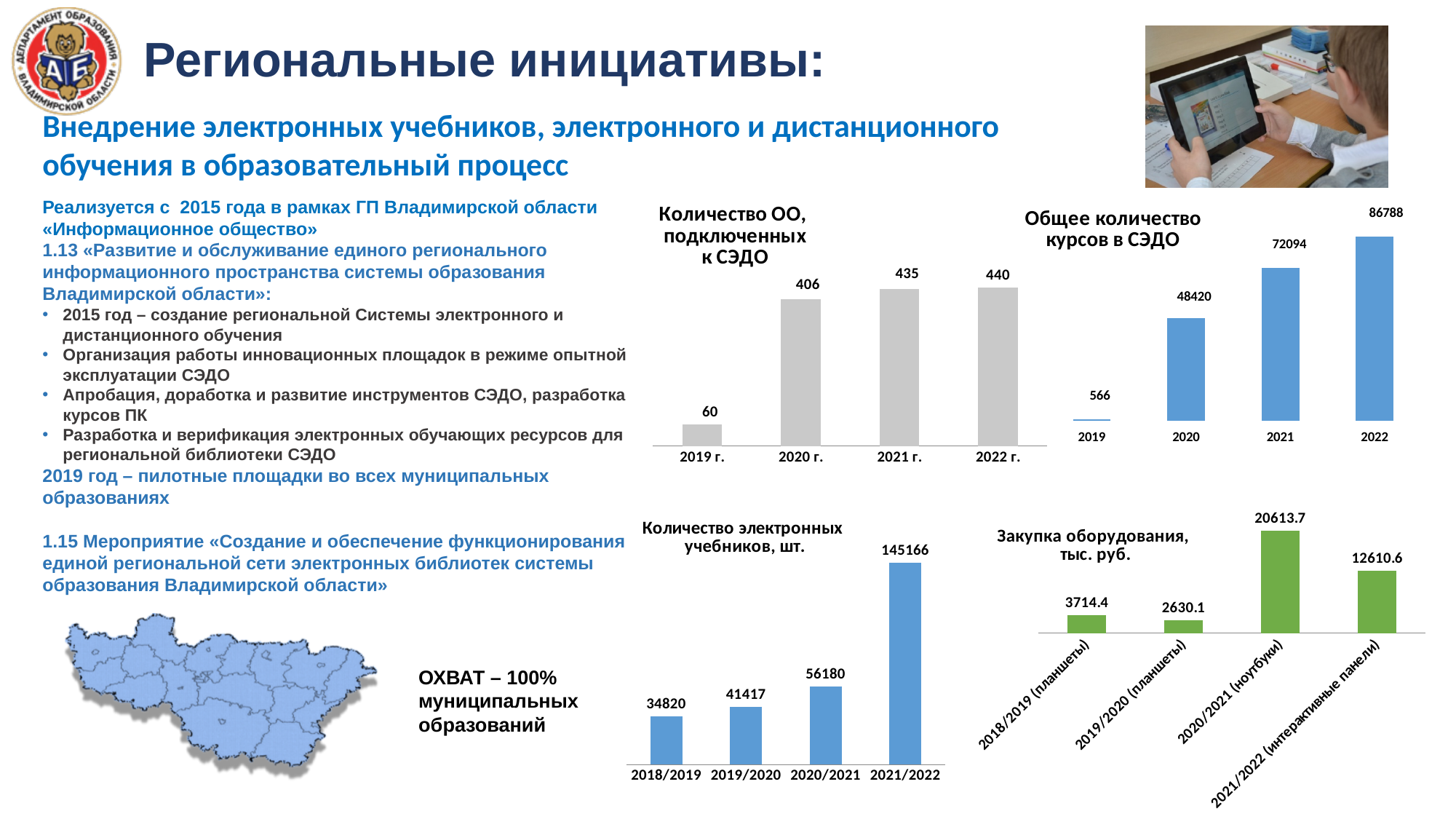
In the chart 'Количество электронных учебников, шт.', how many categories are shown on the x axis? 4 What type of chart is 'Закупка оборудования, тыс. руб.'? bar chart In the chart 'Количество ОО, подключенных к СЭДО', what is the value for 2019 г.? 60 In the chart 'Закупка оборудования, тыс. руб.', what is the value for 2020/2021 (ноутбуки)? 20613.7 In the chart 'Количество ОО, подключенных к СЭДО', what is the difference between the values for 2020 г. and 2019 г.? 346 In the chart 'Общее количество курсов в СЭДО', what is the value for 2021? 72094 In the chart 'Закупка оборудования, тыс. руб.', which is larger: the value for 2018/2019 (планшеты) or 2019/2020 (планшеты)? 2018/2019 (планшеты) In the chart 'Общее количество курсов в СЭДО', do the values rise or fall from 2019 to 2022? rise In the chart 'Общее количество курсов в СЭДО', which year has the lowest value? 2019 In the chart 'Количество электронных учебников, шт.', what is the value for 2021/2022? 145166 In the chart 'Количество ОО, подключенных к СЭДО', which year has the highest value? 2022 г. In the chart 'Количество электронных учебников, шт.', what is the difference between the values for 2020/2021 and 2019/2020? 14763